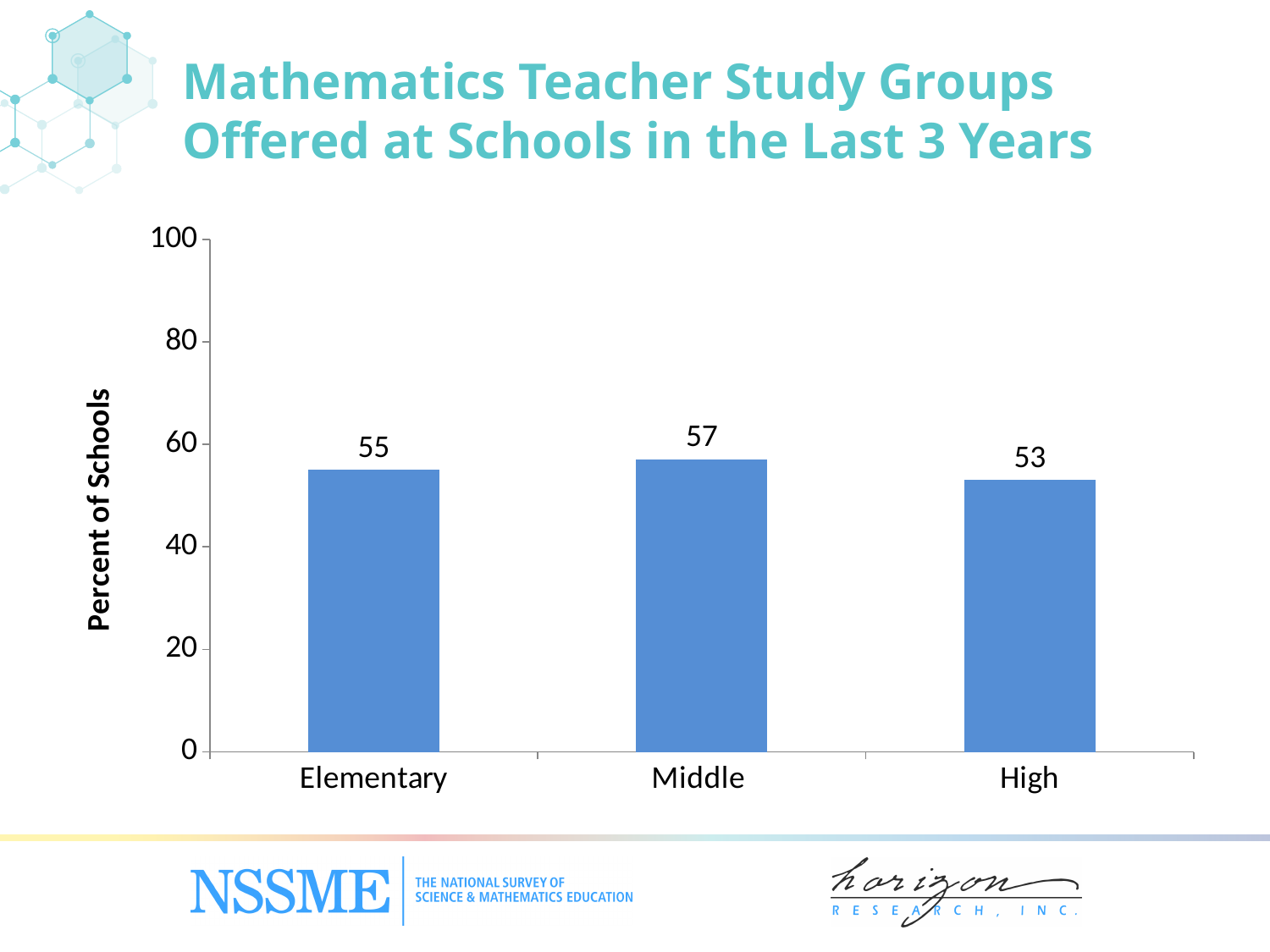
How many school levels are shown on the x axis? 3 Which school level has the highest percent of schools offering mathematics teacher study groups? Middle Is the value for Middle schools greater or less than 60? less What percent of elementary schools offered mathematics teacher study groups in the last 3 years? 55 What is the value shown for High schools? 53 What kind of chart is shown on the slide? bar chart What is the value shown for Middle schools? 57 What is the label of the y axis? Percent of Schools Which is larger, the value for Elementary or the value for High? Elementary What is the difference between the values for Middle and High schools? 4 Which school level has the lowest percent of schools? High What is the difference between the values for Elementary and Middle schools? 2